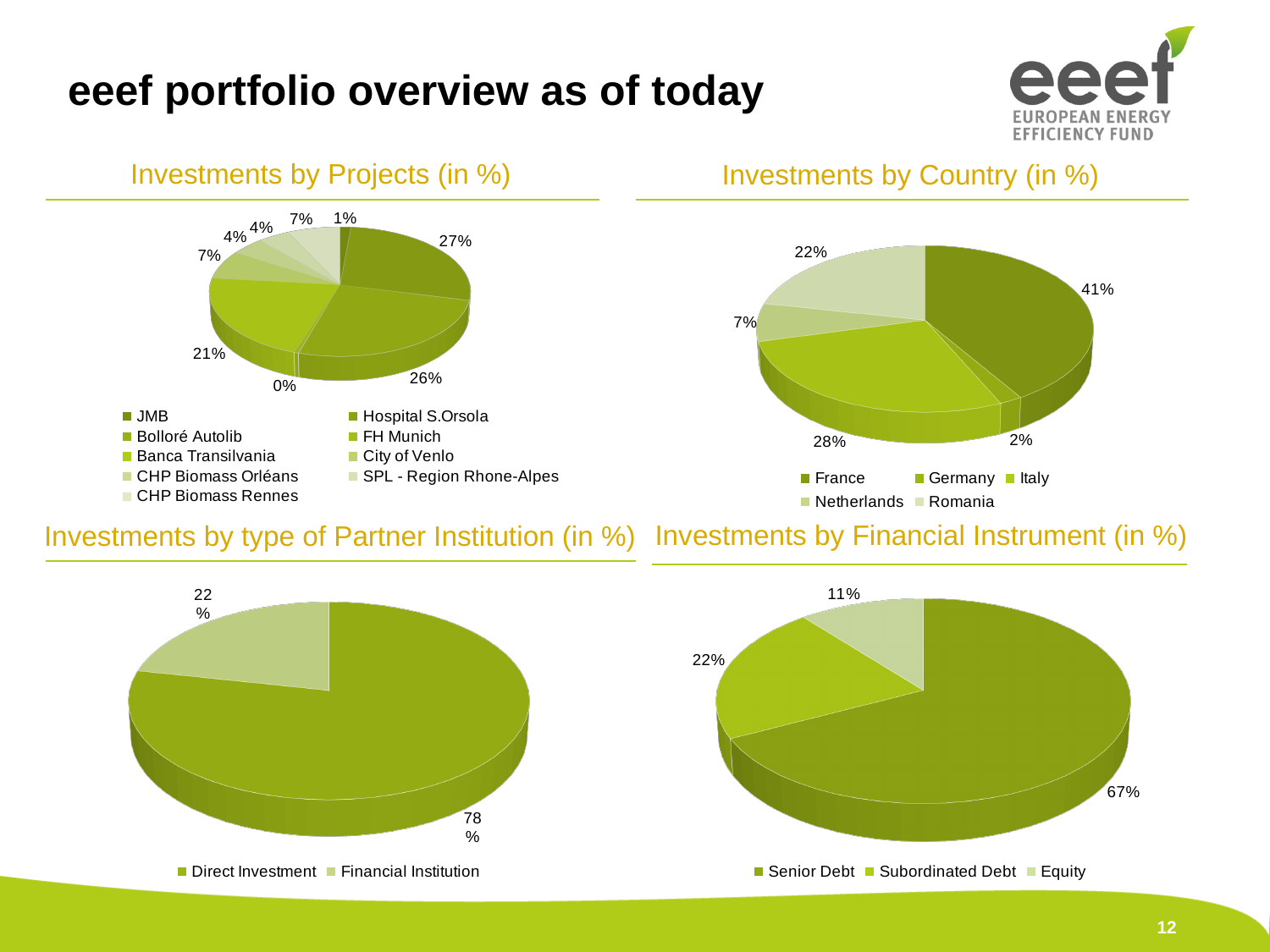
In the 'Investments by Financial Instrument (in %)' chart, what share does Senior Debt have? 67% In the 'Investments by Projects (in %)' chart, what share does JMB have? 1% In the 'Investments by Country (in %)' chart, what share does France have? 41% In the 'Investments by type of Partner Institution (in %)' chart, which category has the largest share? Direct Investment In the 'Investments by Country (in %)' chart, what is the difference between the shares of Germany and the Netherlands? 5% How many categories are listed in the legend of the 'Investments by Projects (in %)' chart? 9 In the 'Investments by Financial Instrument (in %)' chart, which is larger, Subordinated Debt or Equity? Subordinated Debt In the 'Investments by type of Partner Institution (in %)' chart, what share does Financial Institution have? 22% In the 'Investments by Country (in %)' chart, which country has the smallest share? Germany In the 'Investments by Country (in %)' chart, how many countries are shown in the legend? 5 What type of chart is used for 'Investments by Financial Instrument (in %)'? Pie chart In the 'Investments by Country (in %)' chart, what share does Romania have? 22%